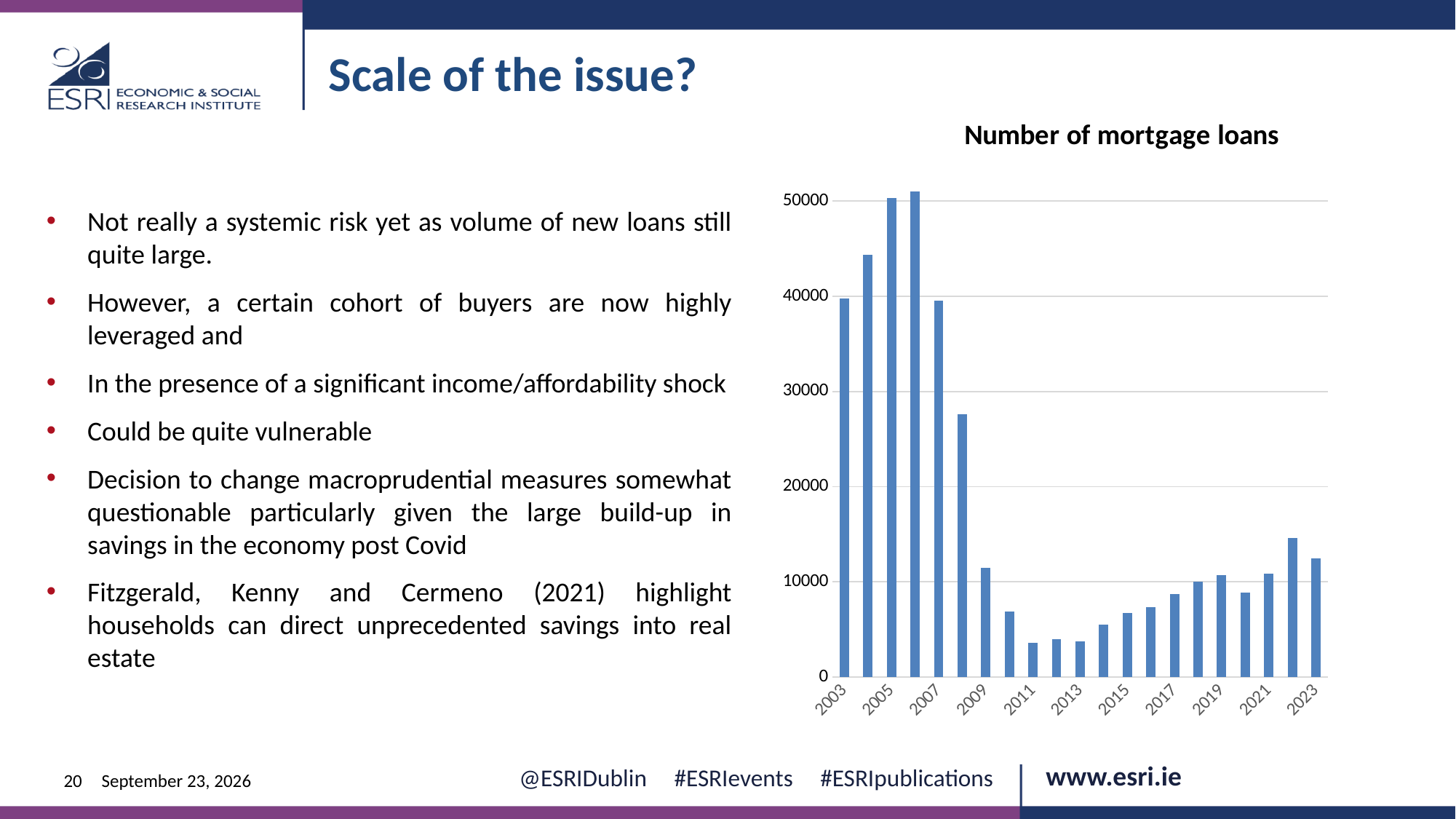
What kind of chart is shown on the slide? bar chart Is the number of mortgage loans in 2005 greater or less than 40000? greater How many bars (years) are plotted in the chart? 21 Do the values rise or fall from 2011 to 2019? rise Is the number of mortgage loans in 2009 greater or less than 20000? less Is the number of mortgage loans in 2017 greater or less than 10000? less Which year has more mortgage loans, 2022 or 2023? 2022 Do the values rise or fall from 2006 to 2011? fall What is the title of the chart? Number of mortgage loans Which year has more mortgage loans, 2005 or 2009? 2005